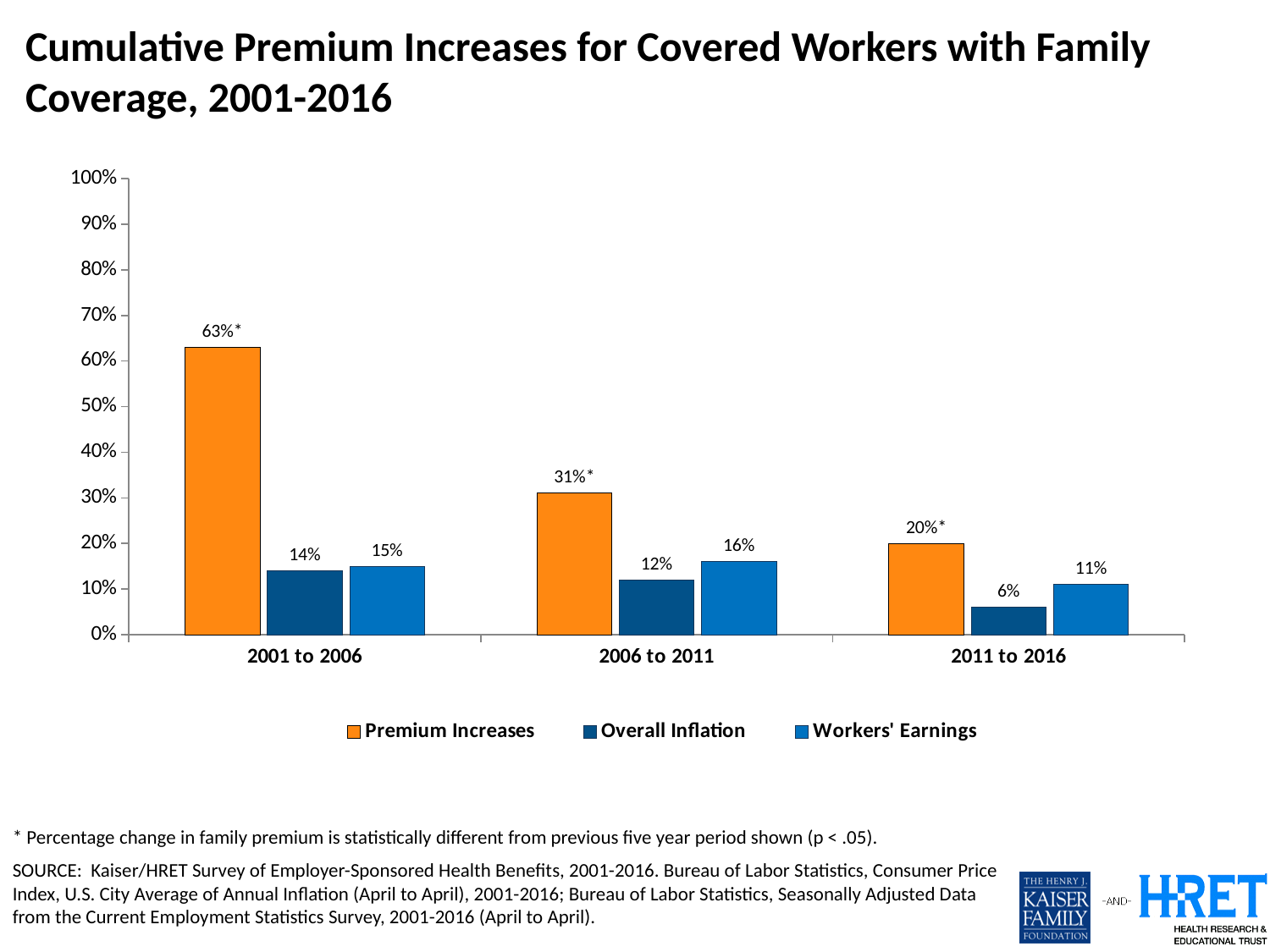
How many series does the legend list? 3 What is the Workers' Earnings value for 2011 to 2016? 11% What is the Overall Inflation value for 2006 to 2011? 12% What is the Premium Increases value for 2001 to 2006? 63%* Which period has the lowest Overall Inflation value? 2011 to 2016 How many periods are shown on the x axis? 3 Do the Premium Increases values rise or fall across the periods from 2001 to 2006 through 2011 to 2016? Fall What is the difference between Premium Increases and Workers' Earnings for 2006 to 2011? 15% Is the Premium Increases value for 2001 to 2006 greater or less than 50%? greater Which is larger for 2011 to 2016: Overall Inflation or Workers' Earnings? Workers' Earnings What kind of chart is shown on the slide? Bar chart Which period has the highest Premium Increases value? 2001 to 2006